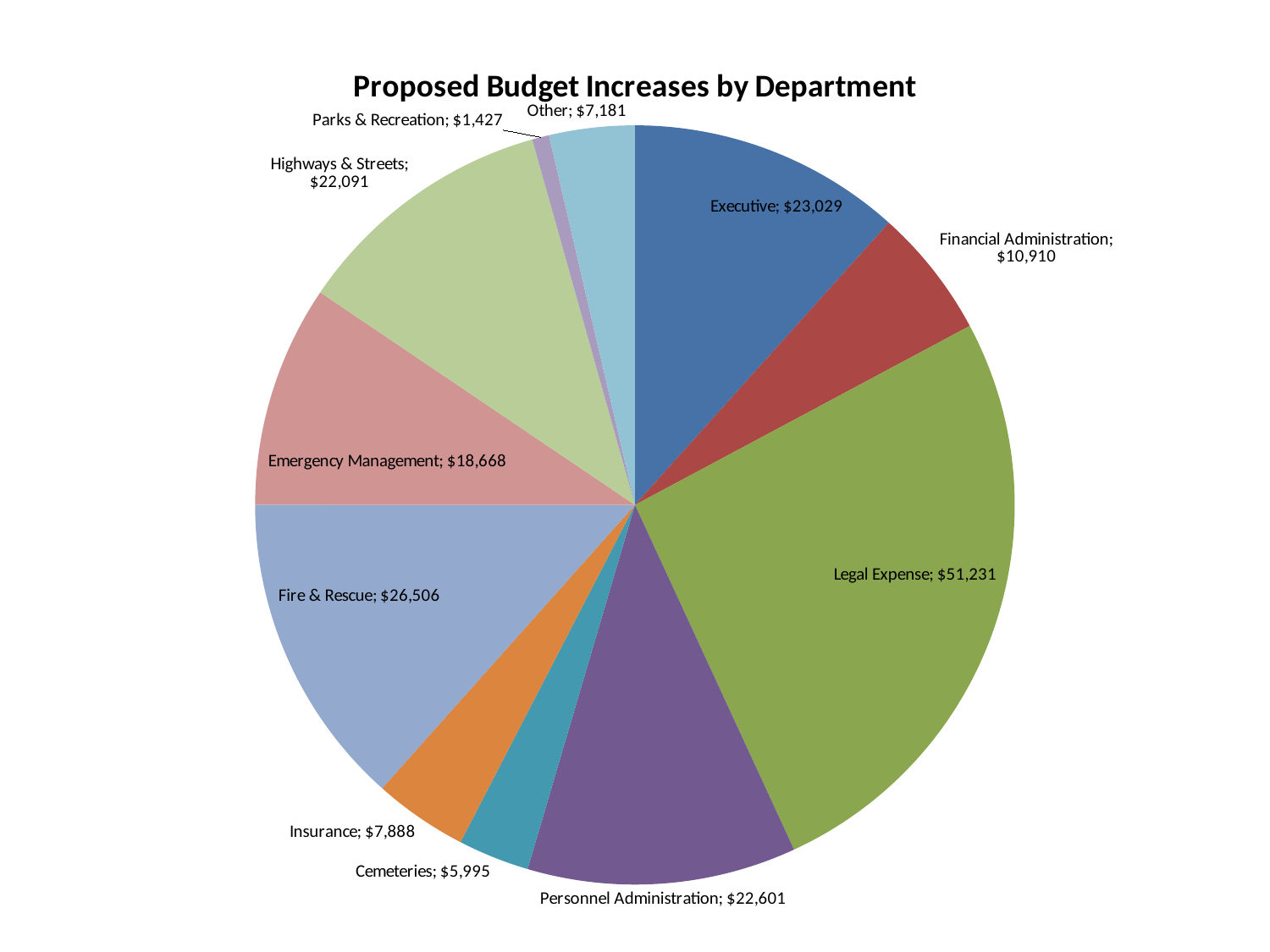
What is the difference between the Legal Expense and Personnel Administration proposed budget increases? $28,630 What kind of chart is shown on the slide? Pie chart What is the difference between the Fire & Rescue and Executive proposed budget increases? $3,477 Which department has the largest proposed budget increase? Legal Expense Which is larger, the proposed increase for Insurance or for Cemeteries? Insurance What is the proposed budget increase for Fire & Rescue? $26,506 Which is larger, the proposed increase for Highways & Streets or for Financial Administration? Highways & Streets What is the proposed budget increase for Emergency Management? $18,668 What is the title of the chart? Proposed Budget Increases by Department How many departments are shown in the pie chart? 11 Which department has the smallest proposed budget increase? Parks & Recreation What is the proposed budget increase for Legal Expense? $51,231